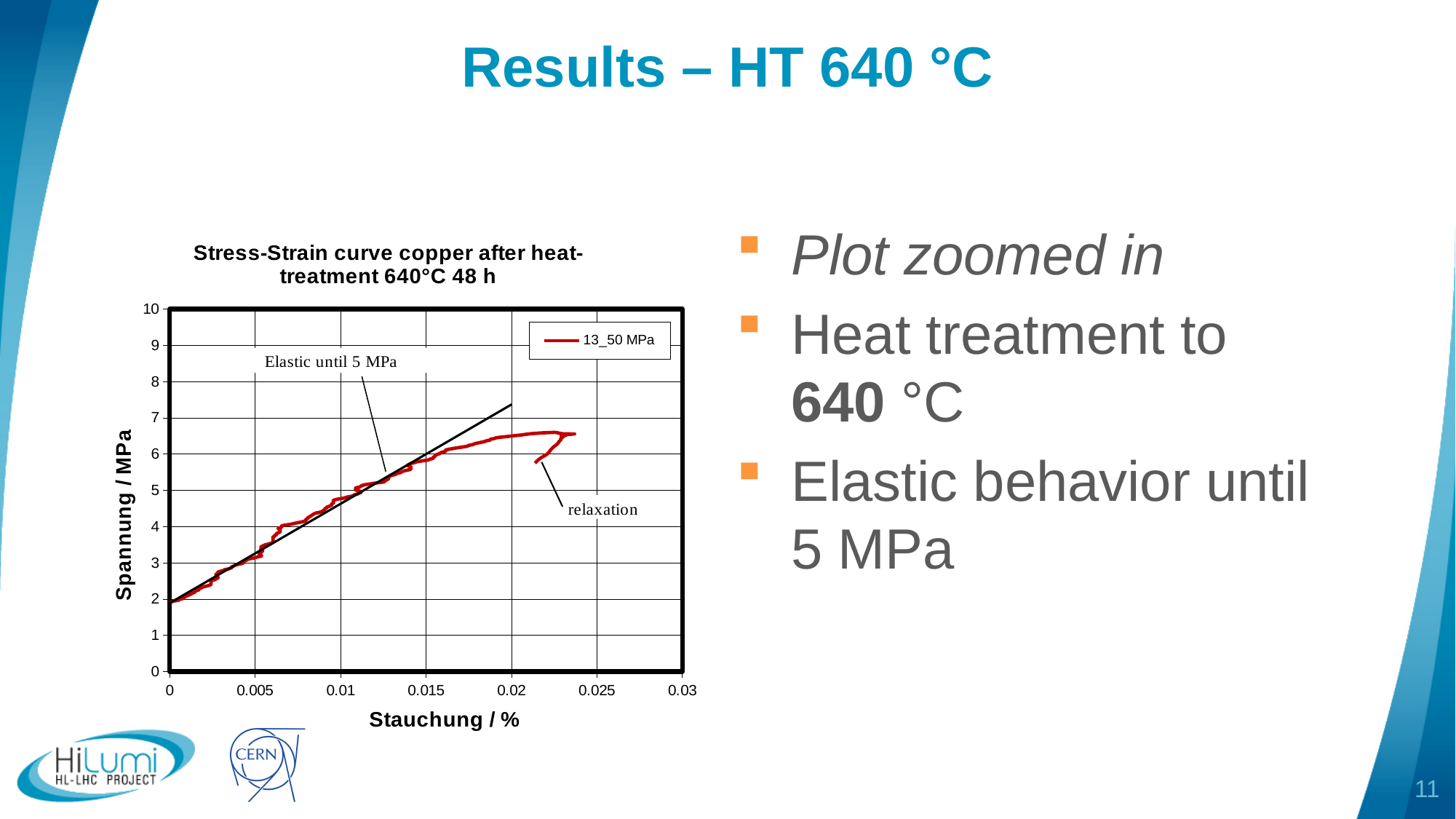
Does the stress of the 13_50 MPa curve generally rise or fall as strain increases from 0 to 0.02? rise What is the title of the chart? Stress-Strain curve copper after heat-treatment 640°C 48 h What is the name of the series listed in the chart legend? 13_50 MPa What is the maximum value shown on the y axis of the chart? 10 How many series does the chart legend list? 1 What is the label of the y axis of the chart? Spannung / MPa Is the stress of the 13_50 MPa curve at a strain of 0.005 greater or less than 4 MPa? less Is the highest stress reached by the 13_50 MPa curve greater or less than 7 MPa? less Is the stress of the 13_50 MPa curve at a strain of 0.02 greater or less than 5 MPa? greater What kind of chart is shown on the slide? line chart What is the label of the x axis of the chart? Stauchung / % What is the maximum value shown on the x axis of the chart? 0.03